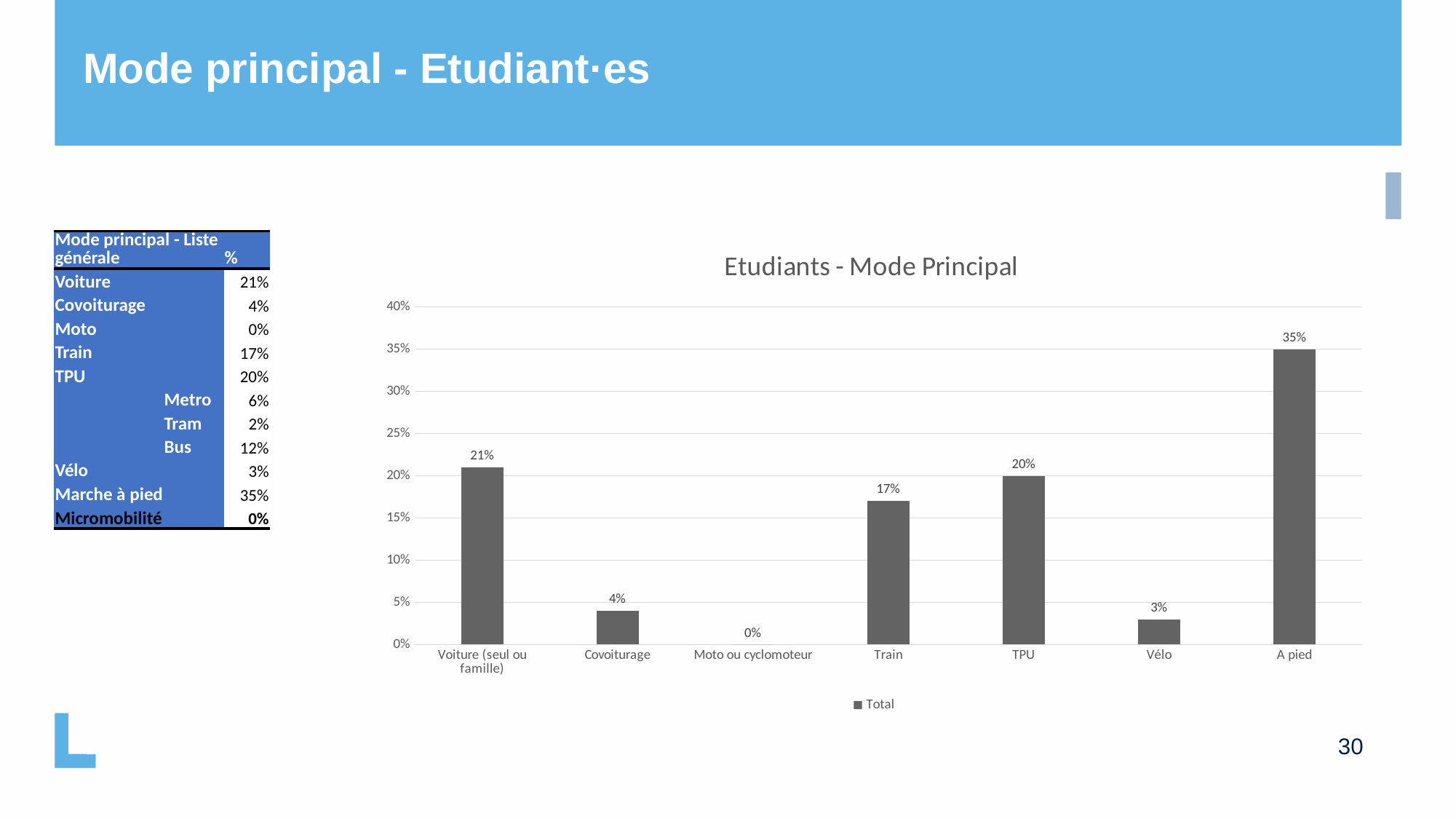
What is the title of the chart? Etudiants - Mode Principal Which category has the highest value? A pied What is the value for Train? 17% How many series does the legend list? 1 How many categories are shown on the x axis? 7 What is the value for A pied? 35% Which category has the lowest value? Moto ou cyclomoteur Is the value for Vélo greater or less than 5%? less What is the value for Covoiturage? 4% What is the difference between the values for A pied and Voiture (seul ou famille)? 14% What kind of chart is shown? bar chart Which is larger, the value for TPU or the value for Train? TPU